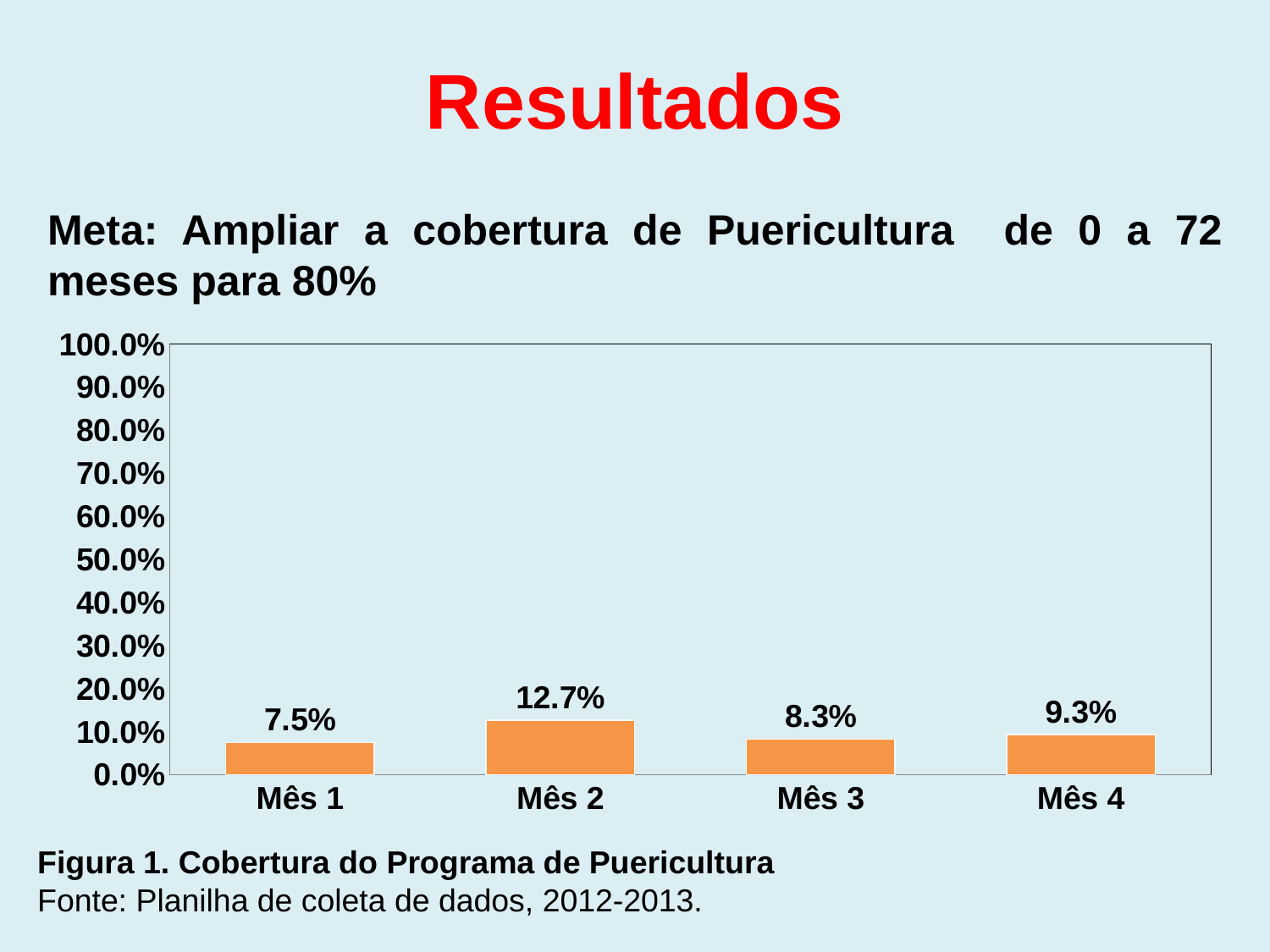
Is the value for Mês 2 greater or less than 20.0%? less What is the difference between the values for Mês 2 and Mês 1? 5.2% What is the value for Mês 1? 7.5% Which month has the highest value? Mês 2 What kind of chart is shown on the slide? bar chart How many months are shown on the x axis? 4 Which month has the lowest value? Mês 1 What is the value for Mês 3? 8.3% Which is larger, the value for Mês 3 or the value for Mês 4? Mês 4 What is the value for Mês 2? 12.7% What is the caption of the figure below the chart? Figura 1. Cobertura do Programa de Puericultura What is the value for Mês 4? 9.3%